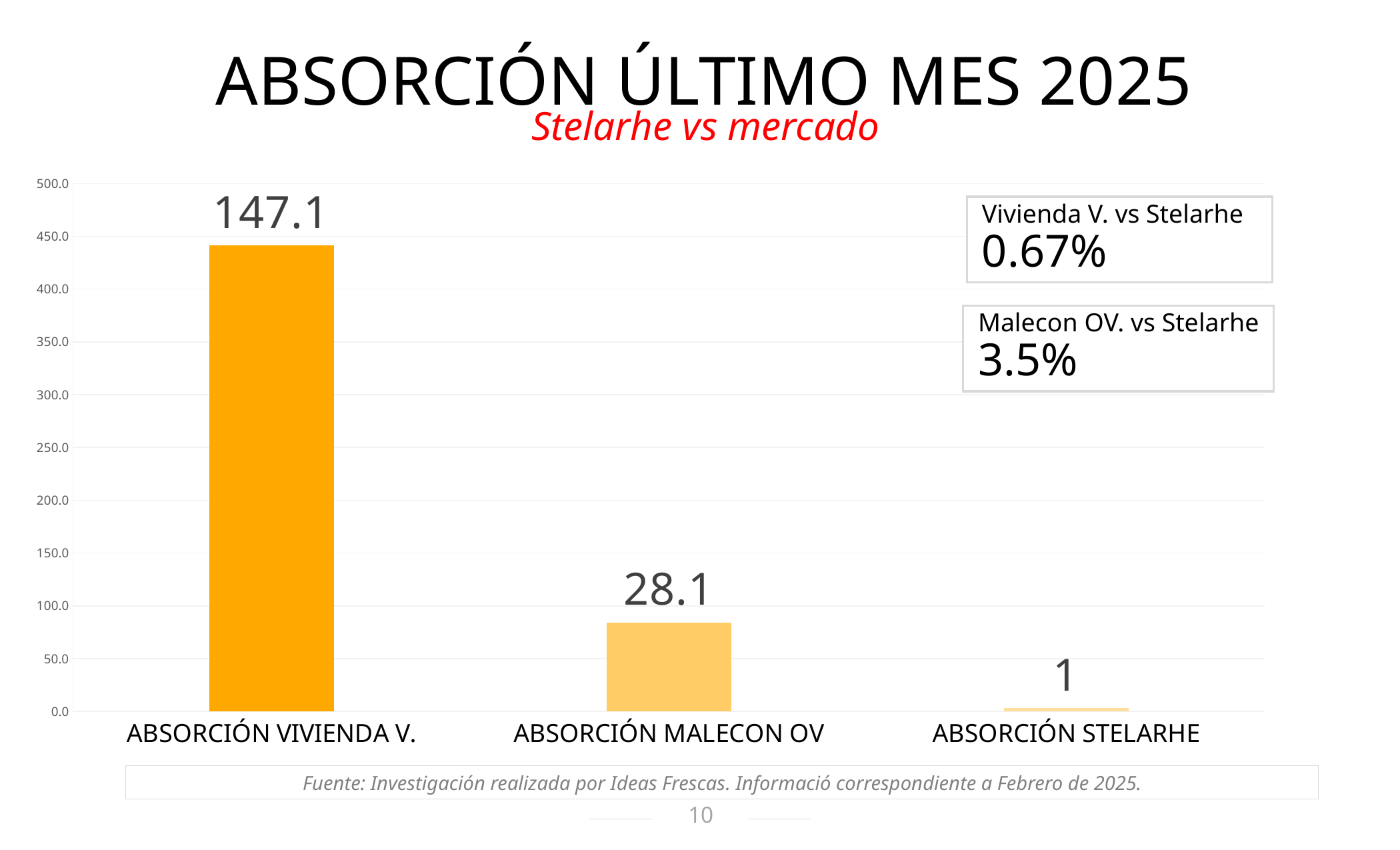
Do the values rise or fall from left to right across the categories? Fall What is the value for ABSORCIÓN MALECON OV? 28.1 What is the value for ABSORCIÓN STELARHE? 1 How many categories are shown in the chart? 3 What is the title of the slide? ABSORCIÓN ÚLTIMO MES 2025 Which is larger, the value for ABSORCIÓN MALECON OV or ABSORCIÓN STELARHE? ABSORCIÓN MALECON OV Which category has the highest value? ABSORCIÓN VIVIENDA V. What is the difference between the values for ABSORCIÓN MALECON OV and ABSORCIÓN STELARHE? 27.1 What kind of chart is shown on the slide? Bar chart What is the difference between the values for ABSORCIÓN VIVIENDA V. and ABSORCIÓN MALECON OV? 119.0 What is the value for ABSORCIÓN VIVIENDA V.? 147.1 Which category has the lowest value? ABSORCIÓN STELARHE